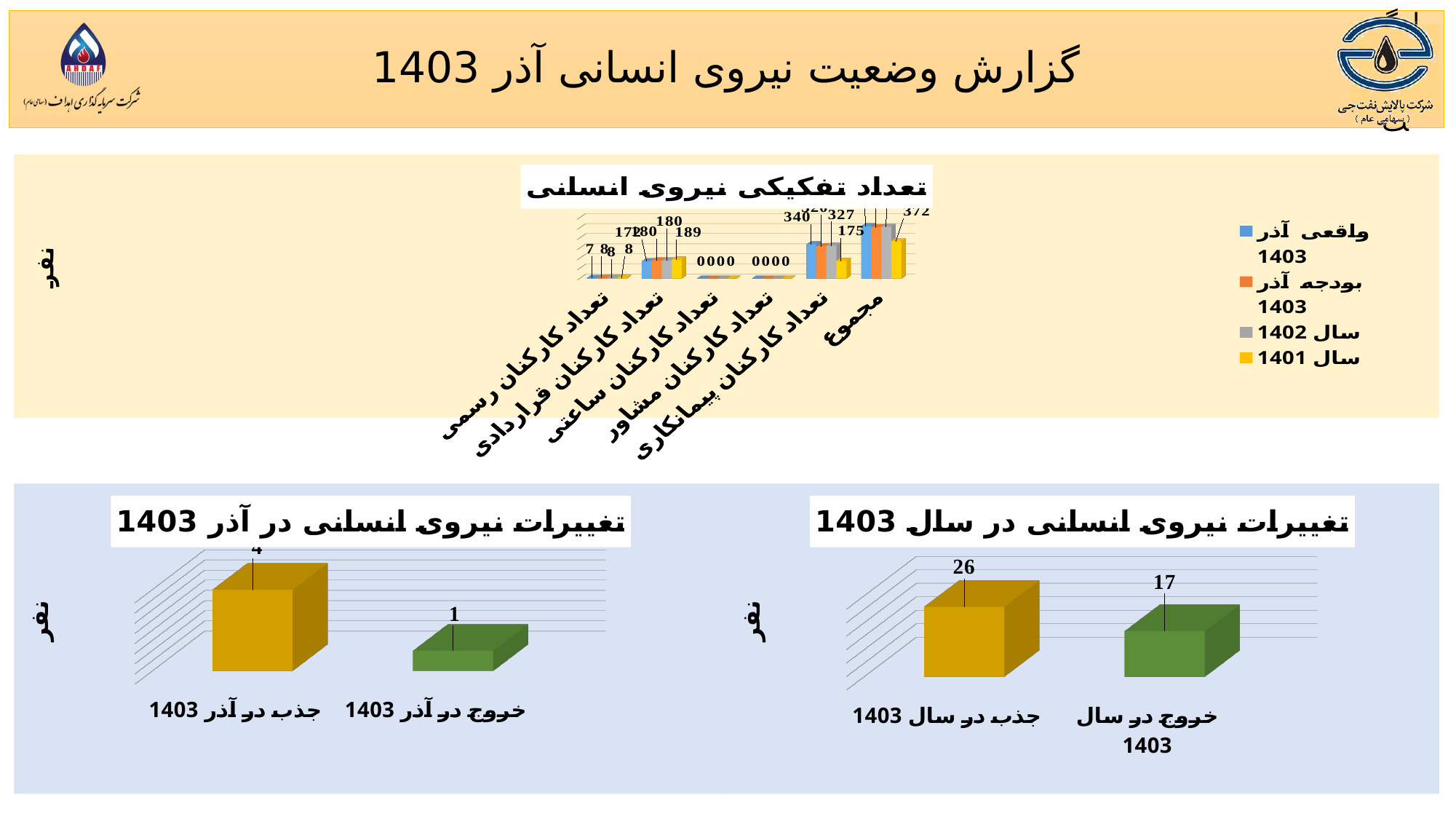
In the chart titled 'تغییرات نیروی انسانی در سال 1403' (bottom right), what is the value for 'خروج در سال 1403'? 17 In the top chart 'تعداد تفکیکی نیروی انسانی', what is the value for 'مجموع' in the series 'سال 1401'? 372 In the chart titled 'تغییرات نیروی انسانی در سال 1403' (bottom right), what is the value for 'جذب در سال 1403'? 26 In the top chart 'تعداد تفکیکی نیروی انسانی', what is the value for 'تعداد کارکنان قراردادی' in the series 'سال 1401'? 189 How many series does the legend of the top chart 'تعداد تفکیکی نیروی انسانی' list? 4 How many categories are shown on the x axis of the top chart 'تعداد تفکیکی نیروی انسانی'? 6 In the chart titled 'تغییرات نیروی انسانی در آذر 1403' (bottom left), what is the value for 'خروج در آذر 1403'? 1 In the chart titled 'تغییرات نیروی انسانی در سال 1403' (bottom right), which is larger: 'جذب در سال 1403' or 'خروج در سال 1403'? جذب در سال 1403 What kind of chart is the top chart 'تعداد تفکیکی نیروی انسانی'? bar chart In the chart titled 'تغییرات نیروی انسانی در آذر 1403' (bottom left), which category has the lowest value? خروج در آذر 1403 In the top chart 'تعداد تفکیکی نیروی انسانی', what is the value for 'تعداد کارکنان رسمی' in the series 'واقعی آذر 1403'? 7 In the chart titled 'تغییرات نیروی انسانی در سال 1403' (bottom right), what is the difference between 'جذب در سال 1403' and 'خروج در سال 1403'? 9